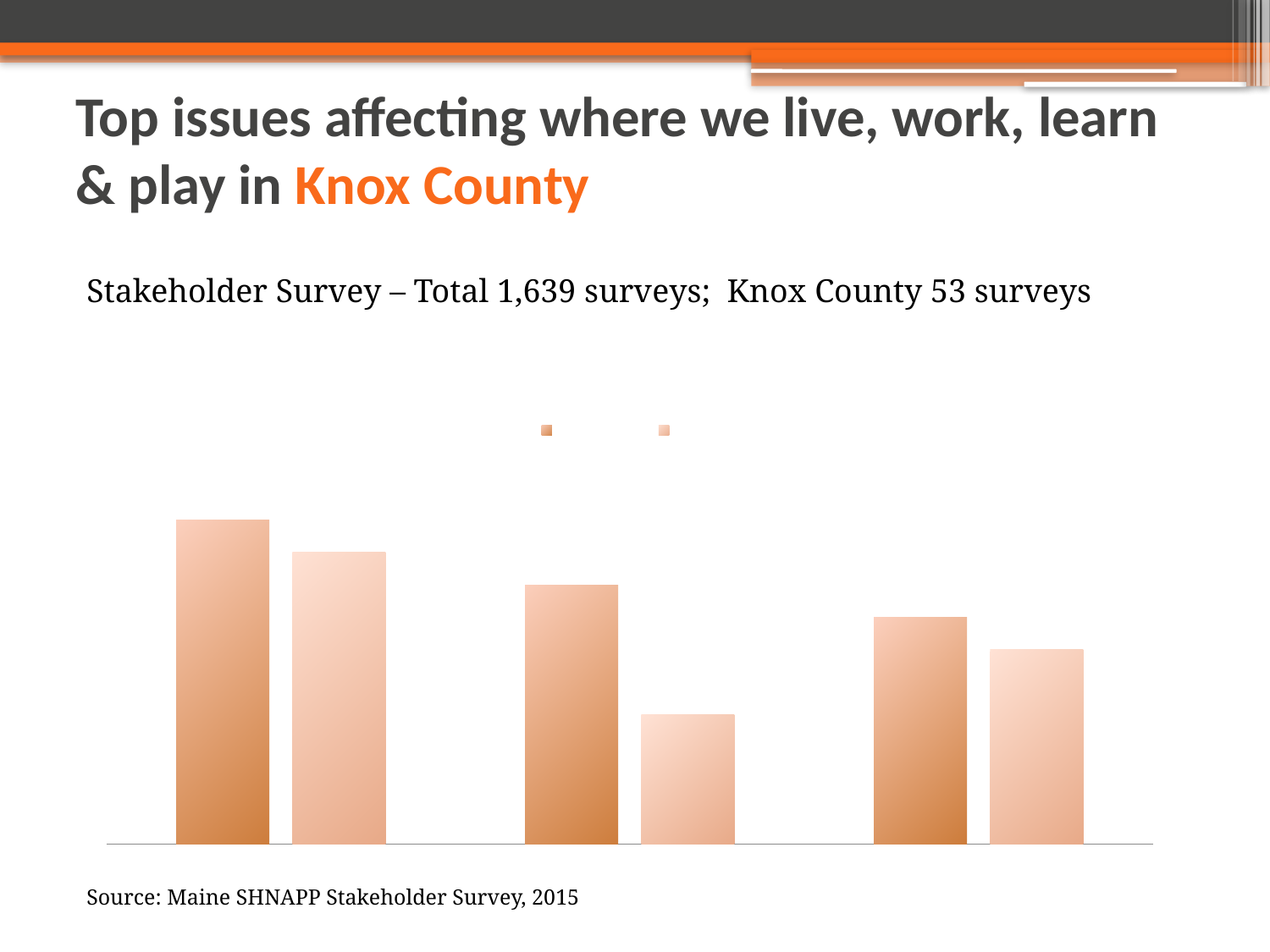
Which group of bars contains the tallest bar on the chart? the leftmost group What kind of chart is shown on the slide? bar chart How many series does the chart's legend list? 2 In the leftmost group of bars, which bar is taller, the darker one or the lighter one? the darker one What two colours are used for the bars in the chart? dark orange and light peach In the middle group of bars, which bar is taller, the darker one or the lighter one? the darker one How many groups of bars does the chart show? 3 In the rightmost group of bars, which bar is taller, the darker one or the lighter one? the darker one Which bar is the shortest on the chart? the lighter bar in the middle group How many bars are plotted in total on the chart? 6 Does the chart display any data labels or axis values? no Do the darker bars rise or fall from left to right across the three groups? fall